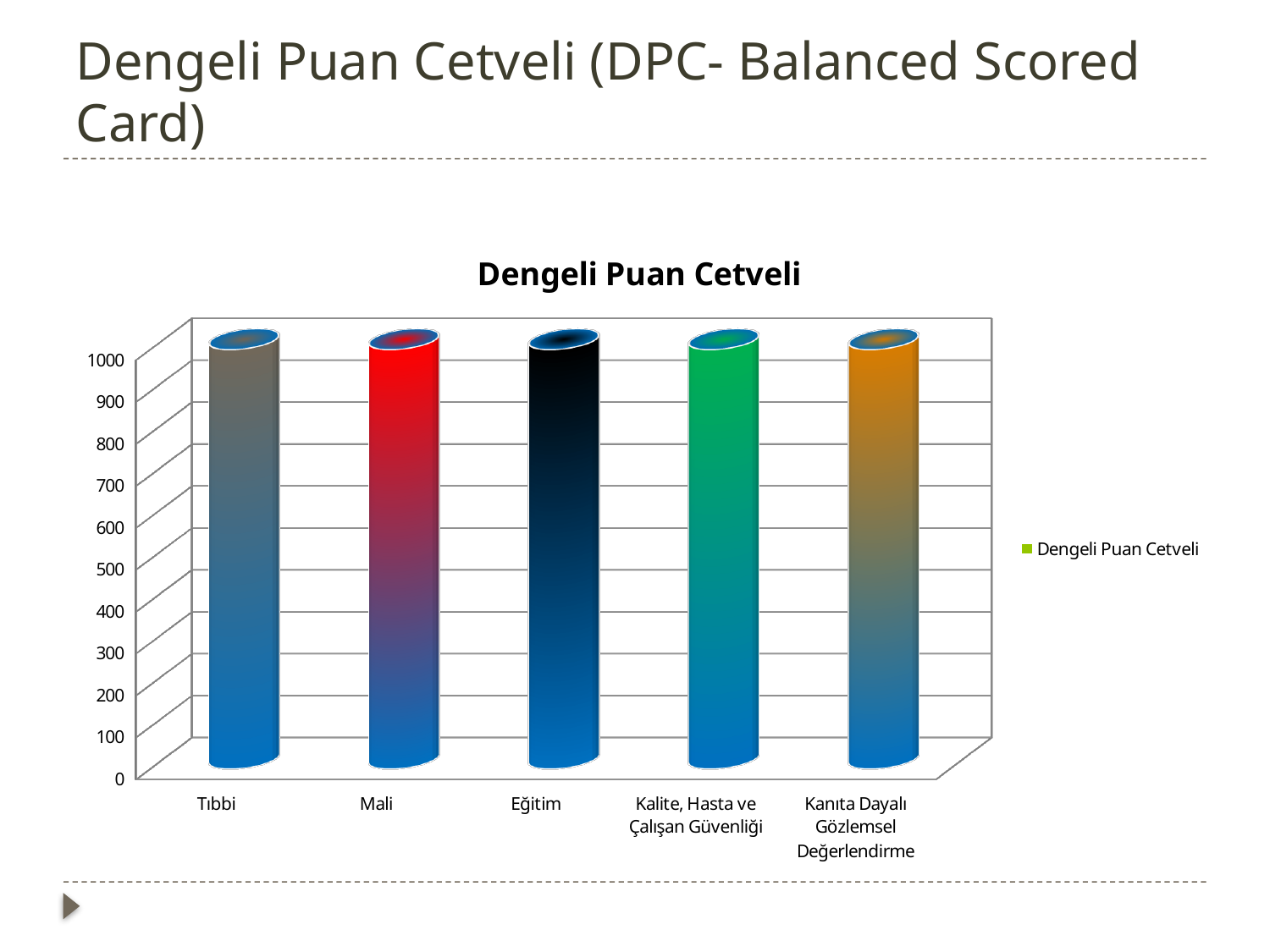
Is the value for Mali greater or less than 800? greater Is the value for Kalite, Hasta ve Çalışan Güvenliği greater or less than 900? greater Is the value for Tıbbi greater or less than 500? greater What is the title of the chart? Dengeli Puan Cetveli What series name is shown in the legend? Dengeli Puan Cetveli How many series does the legend list? 1 What is the highest tick value shown on the vertical axis? 1000 How many categories are shown on the x axis of the chart? 5 What kind of chart is shown on the slide? bar chart